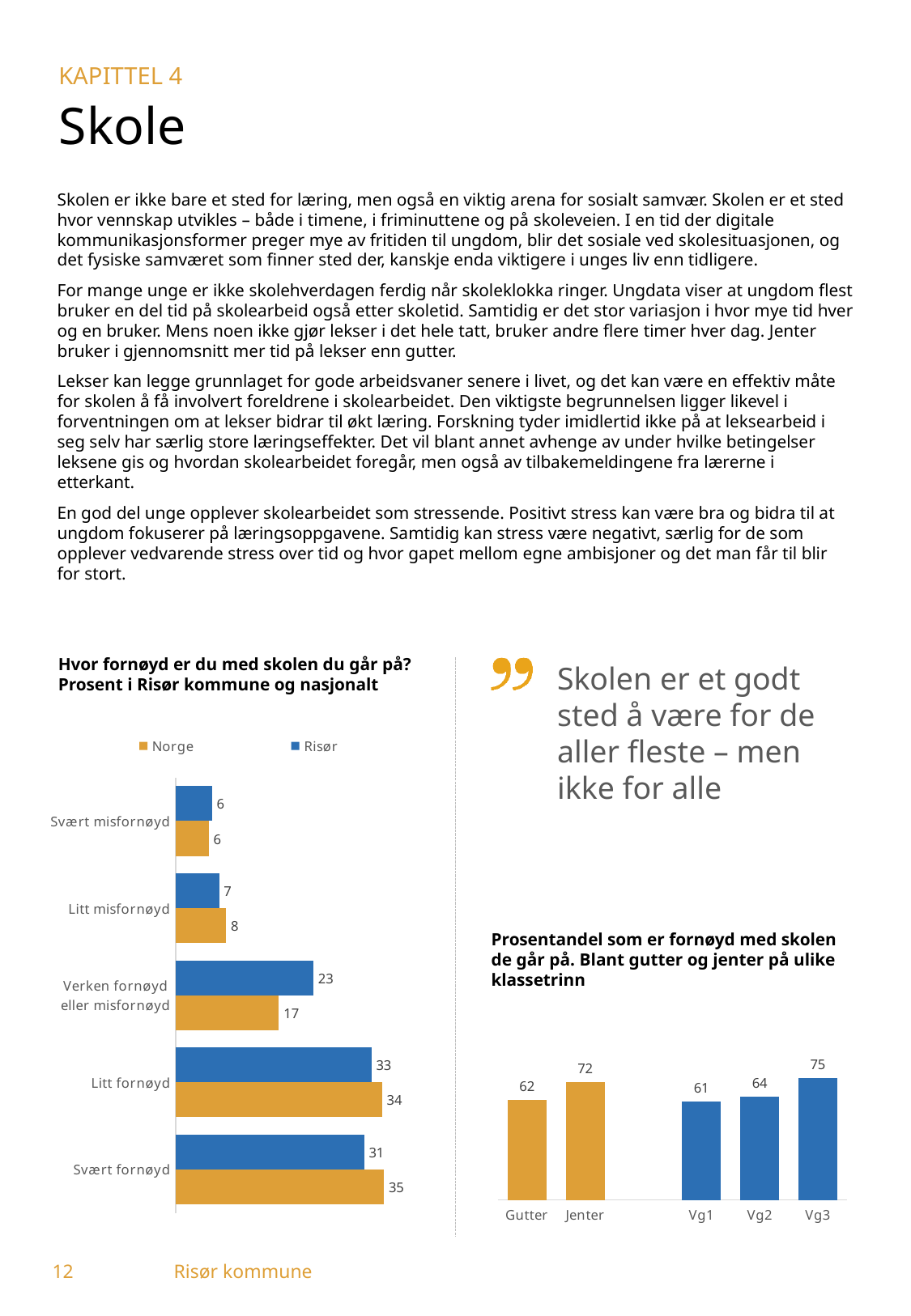
In the chart 'Hvor fornøyd er du med skolen du går på?', what is the Risør value for 'Verken fornøyd eller misfornøyd'? 23 In the chart 'Hvor fornøyd er du med skolen du går på?', what is the difference between the Risør and Norge values for 'Verken fornøyd eller misfornøyd'? 6 In the chart 'Prosentandel som er fornøyd med skolen de går på', which category has the highest value? Vg3 In the chart 'Hvor fornøyd er du med skolen du går på?', what is the Norge value for 'Svært fornøyd'? 35 In the chart 'Hvor fornøyd er du med skolen du går på?', how many categories are shown? 5 In the chart 'Prosentandel som er fornøyd med skolen de går på', what is the difference between Jenter and Gutter? 10 In the chart 'Prosentandel som er fornøyd med skolen de går på', what is the value for Jenter? 72 In the chart 'Hvor fornøyd er du med skolen du går på?', which category has the highest Risør value? Litt fornøyd In the chart 'Hvor fornøyd er du med skolen du går på?', which category has the highest Norge value? Svært fornøyd In the chart 'Prosentandel som er fornøyd med skolen de går på', do the values rise or fall from Vg1 to Vg3? Rise What kind of chart is 'Hvor fornøyd er du med skolen du går på?'? Bar chart In the chart 'Hvor fornøyd er du med skolen du går på?', how many series does the legend list? 2